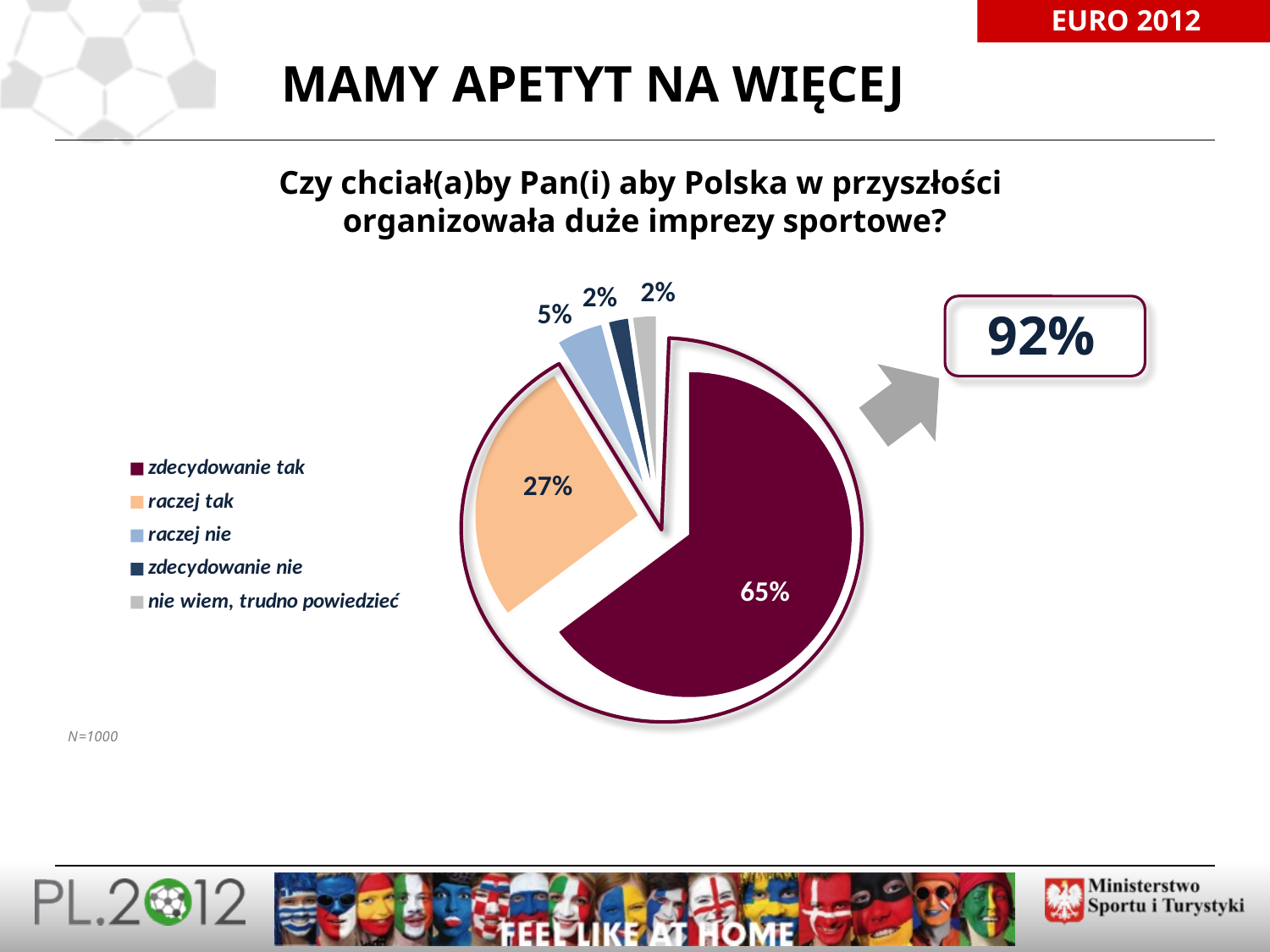
What type of chart is shown on the slide? pie chart What percentage of respondents answered "raczej tak"? 27% What is the difference in percentage points between "zdecydowanie tak" and "raczej tak"? 38 What percentage of respondents answered "zdecydowanie nie"? 2% Which answer category has the largest share of the pie? zdecydowanie tak Which is larger, the share for "raczej tak" or the share for "raczej nie"? raczej tak How many slices does the pie chart have? 5 What percentage of respondents answered "zdecydowanie tak"? 65% What value is shown in the callout box to the right of the pie chart? 92% What is the combined share of "zdecydowanie tak" and "raczej tak"? 92% How many entries does the legend list? 5 What percentage of respondents answered "raczej nie"? 5%